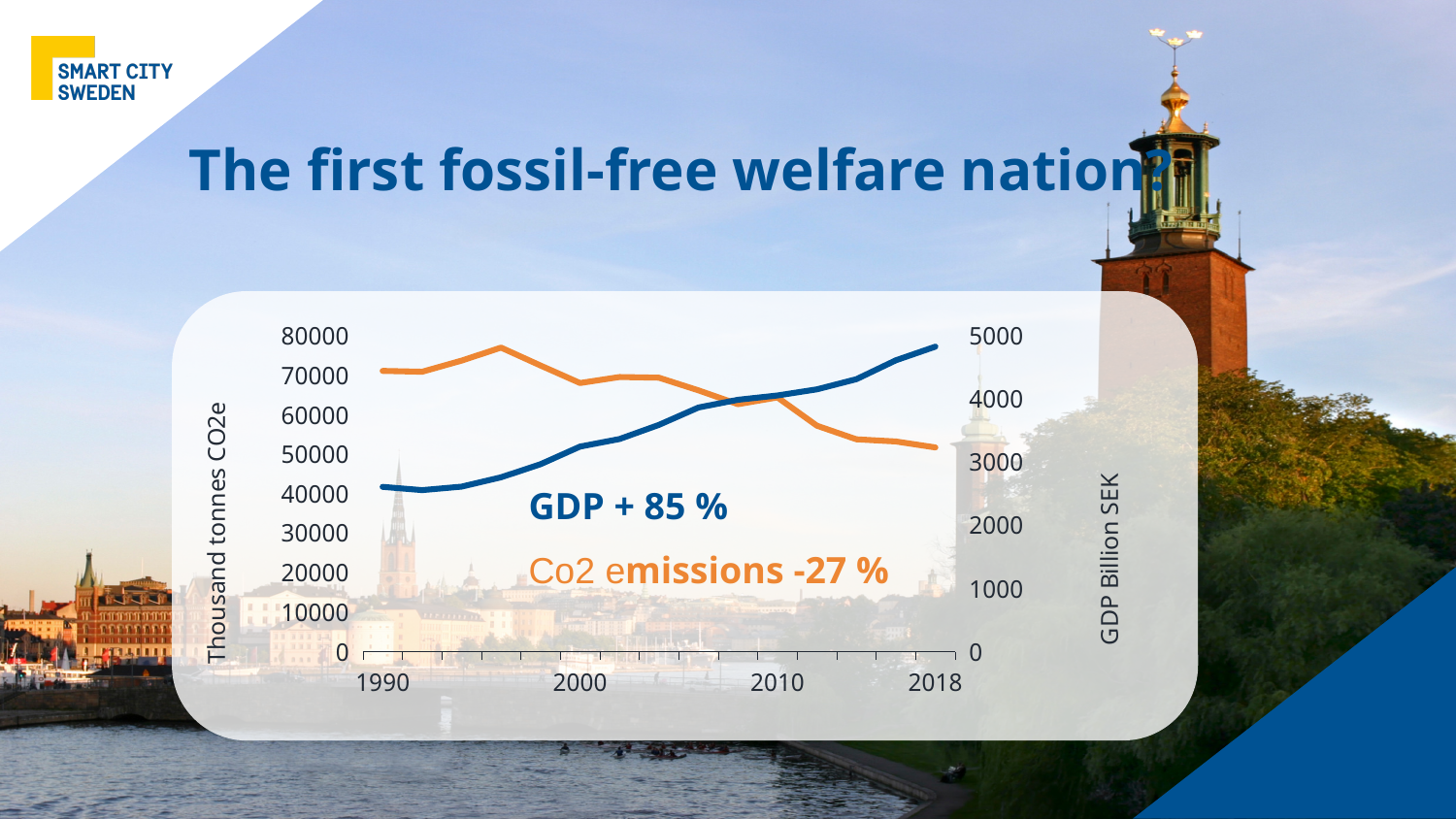
Is the CO2 emissions value in 1990 greater or less than 60000 thousand tonnes CO2e? greater By what percentage did GDP change according to the chart annotation? + 85 % What kind of chart is shown on the slide? Line chart Is the GDP value in 2018 greater or less than 4000 billion SEK? greater Does the GDP line rise or fall from 1990 to 2018? Rise Is the CO2 emissions value in 2018 greater or less than 60000 thousand tonnes CO2e? less Do CO2 emissions rise or fall overall from 1990 to 2018? Fall What is the label of the right vertical axis? GDP Billion SEK What is the label of the left vertical axis? Thousand tonnes CO2e By what percentage did CO2 emissions change according to the chart annotation? -27 % How many data series (lines) are plotted on the chart? 2